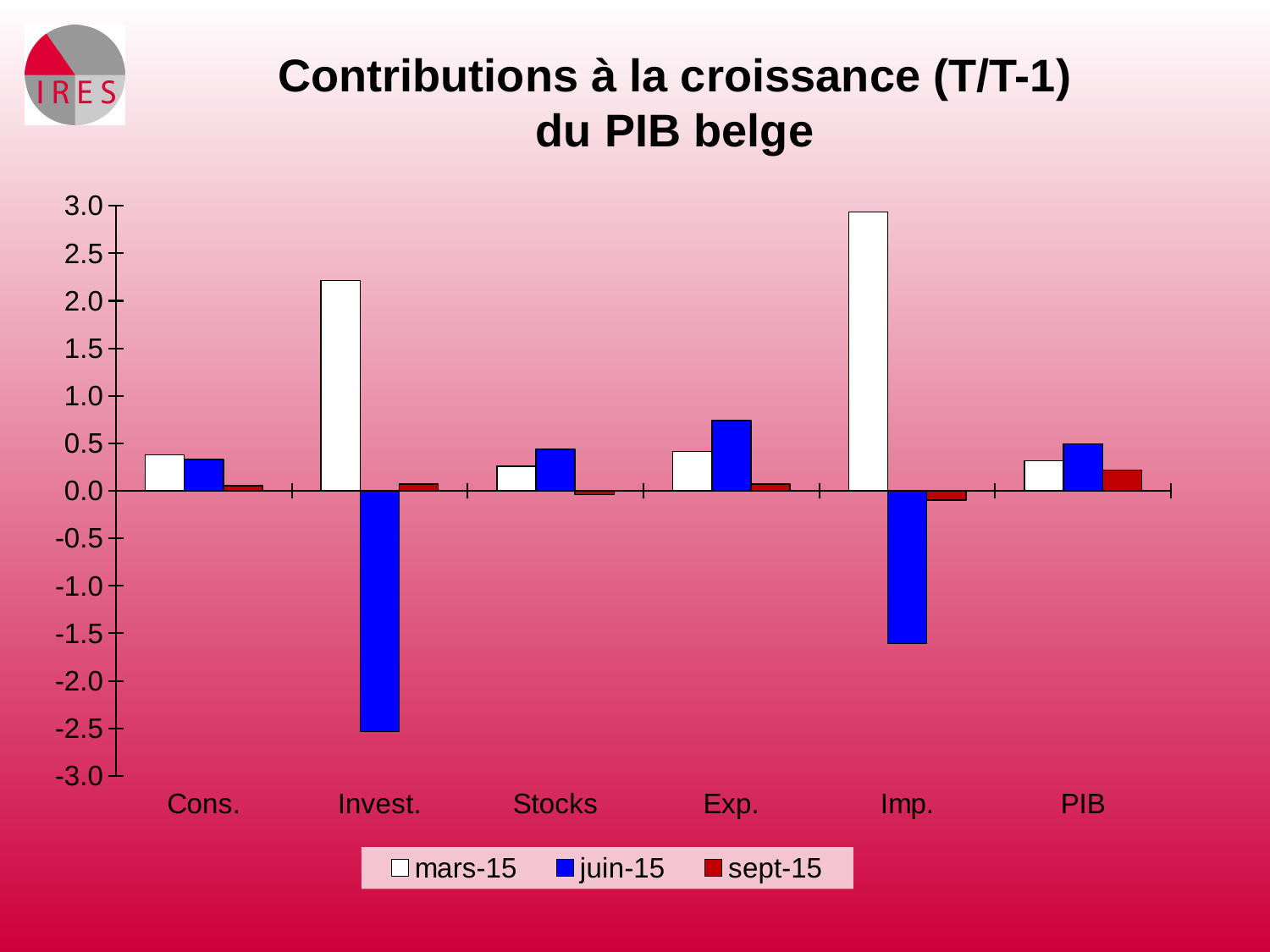
Which category has the lowest value for the juin-15 series? Invest. What is the title of the chart? Contributions à la croissance (T/T-1) du PIB belge Is the juin-15 value for Imp. greater or less than -1.5? less For Exp., which series has the larger value: mars-15 or juin-15? juin-15 How many series does the legend list? 3 For the mars-15 series, which is larger: Invest. or Imp.? Imp. What are the three series listed in the legend? mars-15, juin-15, sept-15 What kind of chart is shown on the slide? bar chart Which category has the highest value for the mars-15 series? Imp. Is the mars-15 value for Invest. greater or less than 2.0? greater Is the juin-15 value for Invest. greater or less than -2.0? less How many categories are shown on the x axis? 6